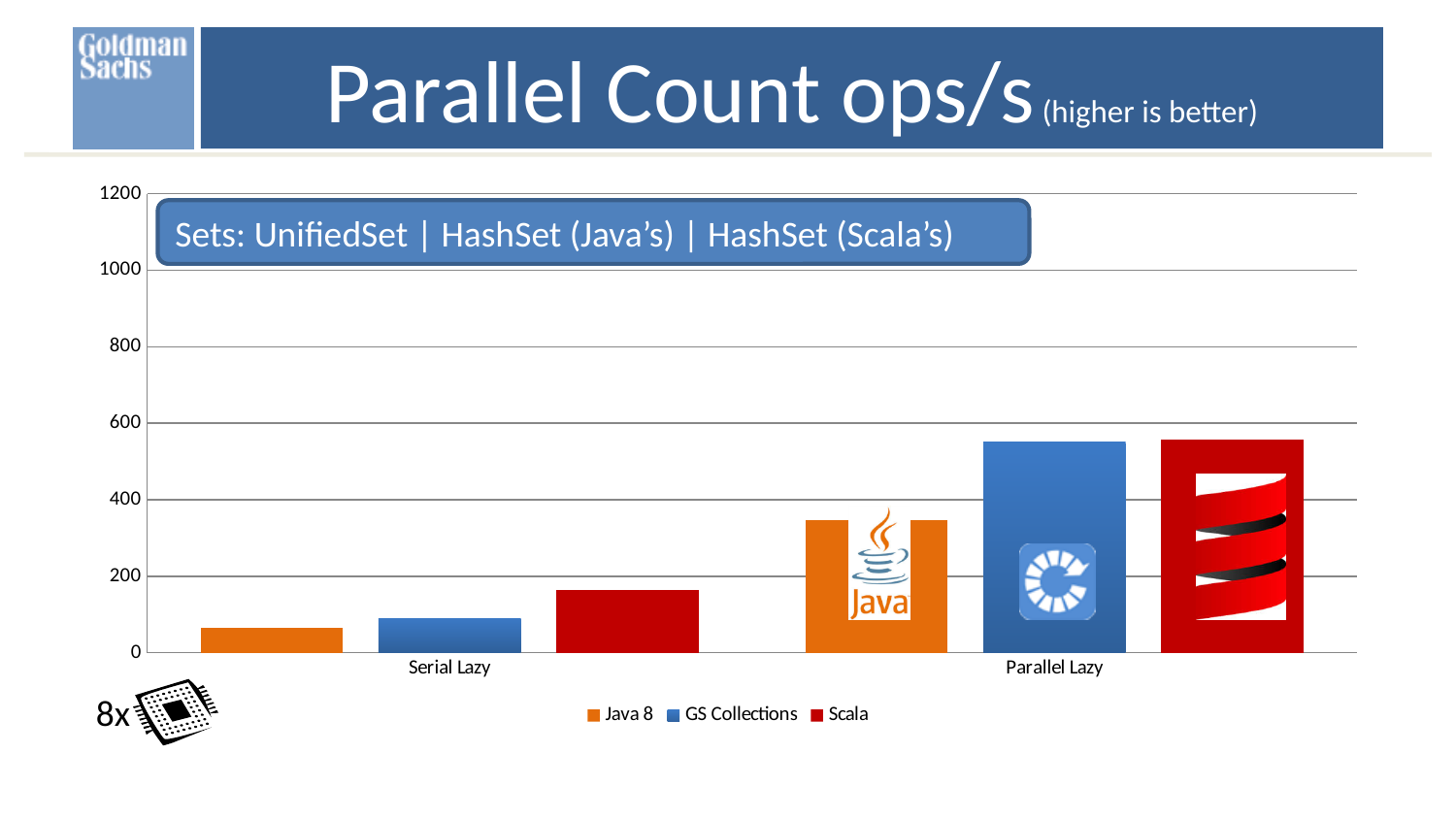
How many categories are shown on the x axis? 2 How many series does the legend list? 3 What is the title of the chart? Parallel Count ops/s (higher is better) Which is larger for Java 8: the Serial Lazy value or the Parallel Lazy value? Parallel Lazy Which series has the highest value in the Serial Lazy category? Scala Which series has the lowest value in the Serial Lazy category? Java 8 Is the value for Java 8 in the Serial Lazy category greater or less than 200? less What kind of chart is shown on the slide? bar chart Is the value for GS Collections in the Parallel Lazy category greater or less than 400? greater Is the value for Scala in the Parallel Lazy category greater or less than 600? less Does the GS Collections value rise or fall from Serial Lazy to Parallel Lazy? rise